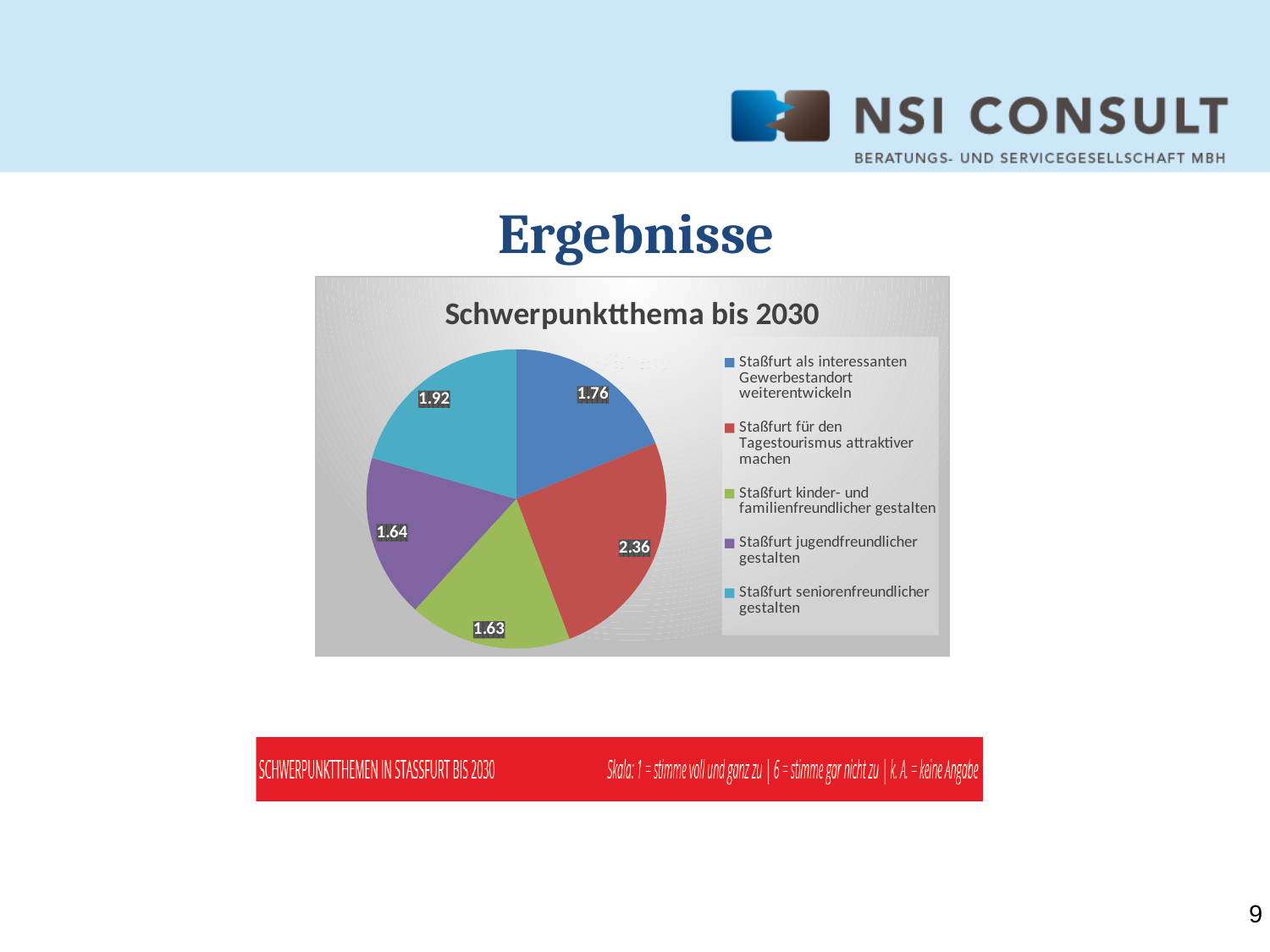
What is the difference between the values for "Staßfurt für den Tagestourismus attraktiver machen" and "Staßfurt als interessanten Gewerbestandort weiterentwickeln"? 0.60 Which category has the lowest value in the pie chart? Staßfurt kinder- und familienfreundlicher gestalten How many slices does the pie chart have? 5 What value is shown for "Staßfurt seniorenfreundlicher gestalten"? 1.92 Which has the larger value: "Staßfurt seniorenfreundlicher gestalten" or "Staßfurt jugendfreundlicher gestalten"? Staßfurt seniorenfreundlicher gestalten What value is shown for "Staßfurt als interessanten Gewerbestandort weiterentwickeln"? 1.76 What value is shown for "Staßfurt kinder- und familienfreundlicher gestalten"? 1.63 What value is shown for "Staßfurt jugendfreundlicher gestalten"? 1.64 What is the title of the chart? Schwerpunktthema bis 2030 What kind of chart is shown on the slide? Pie chart Which category has the highest value in the pie chart? Staßfurt für den Tagestourismus attraktiver machen What value is shown for "Staßfurt für den Tagestourismus attraktiver machen"? 2.36